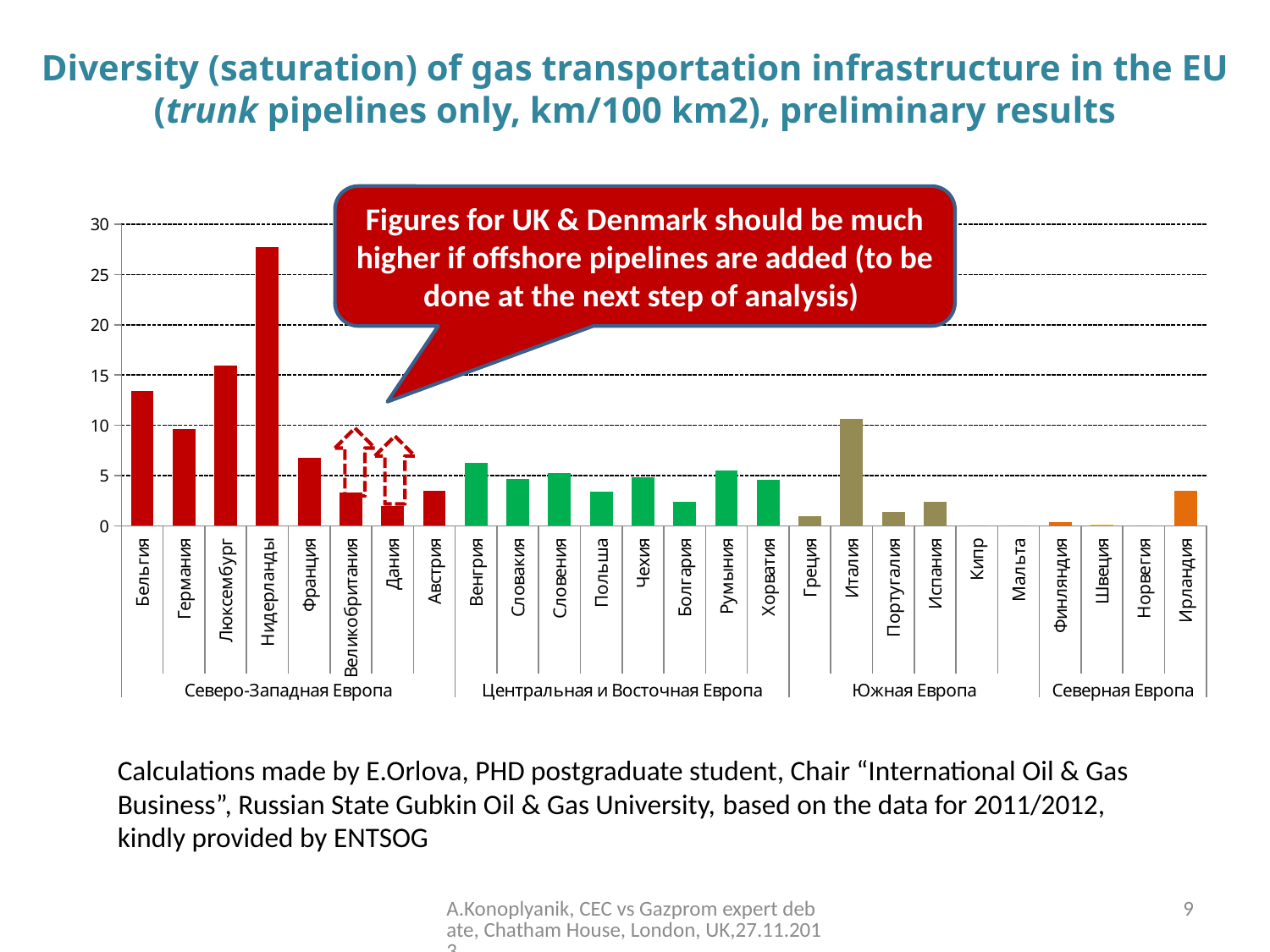
How many regional groups are labelled along the x axis of the chart? 4 Which country in the Южная Европа group has the highest bar? Италия Which country has the highest bar in the chart? Нидерланды Is the value for Нидерланды greater or less than 25? greater What kind of chart is shown on the slide? Bar chart Is the value for Бельгия greater or less than 10? greater Is the value for Италия greater or less than 5? greater Which has the larger value, Бельгия or Германия? Бельгия How many countries are shown on the x axis of the chart? 26 Which has the larger value, Италия or Греция? Италия